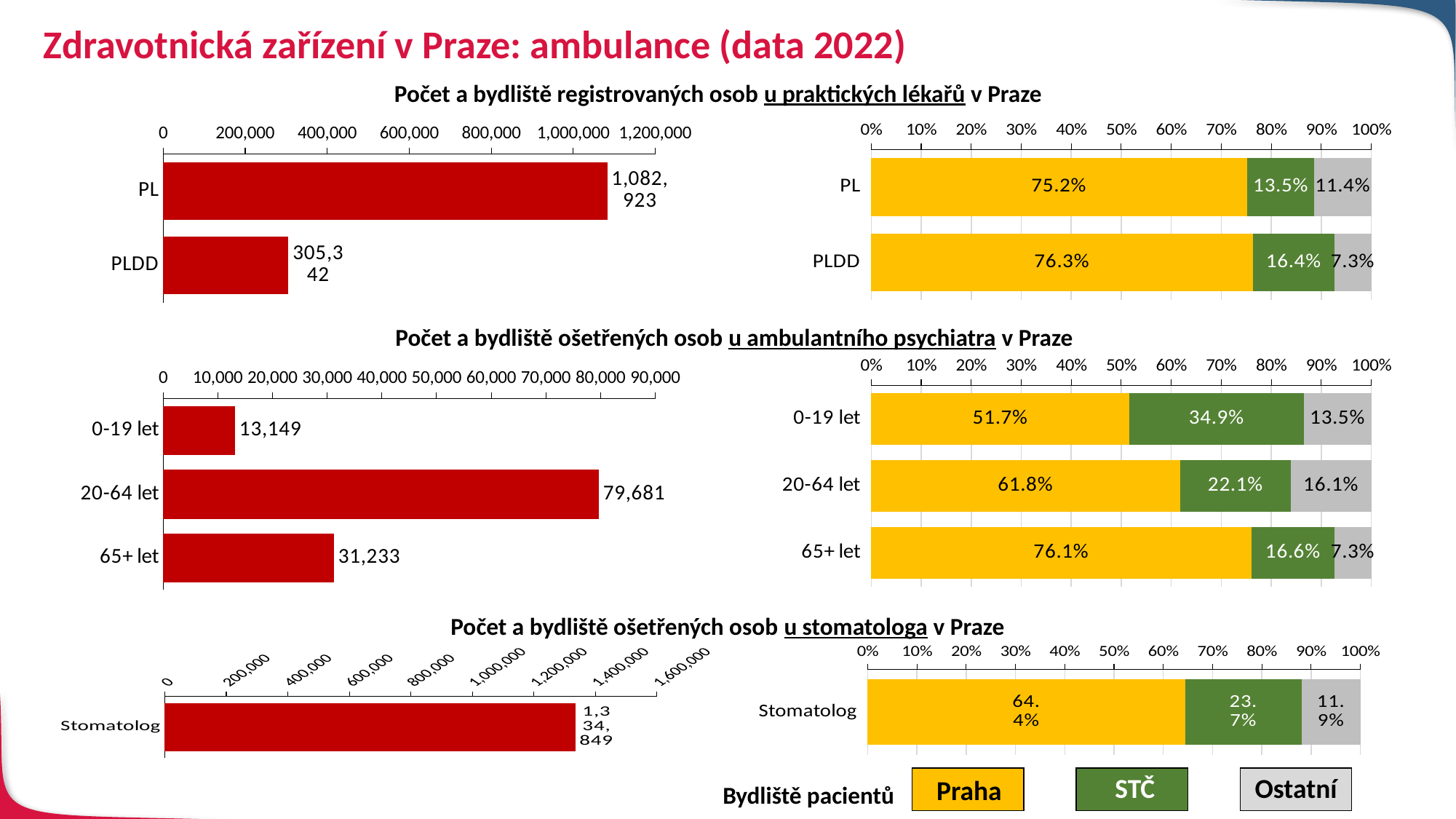
How many patient residence categories does the legend at the bottom of the slide list? 3 In the middle-right stacked bar chart (outpatient psychiatrist), which age group has the largest Praha share? 65+ let In the top-right stacked bar chart (general practitioners), what share of PLDD patients live in STČ? 16.4% In the top-left bar chart (registered persons at general practitioners), what is the value for PL? 1,082,923 In the middle-left bar chart (outpatient psychiatrist), what is the difference between the 20-64 let and 65+ let values? 48,448 In the top-right stacked bar chart (general practitioners), what share of PL patients live in Praha? 75.2% In the middle-left bar chart (outpatient psychiatrist), which age group has the lowest number of treated persons? 0-19 let In the top-left bar chart (registered persons at general practitioners), what is the value for PLDD? 305,342 In the bottom-left bar chart (stomatologist), what is the value for Stomatolog? 1,334,849 In the middle-left bar chart (outpatient psychiatrist), which age group has the highest number of treated persons? 20-64 let In the bottom-right stacked bar chart (stomatologist), what share of patients live in Ostatní (other) regions? 11.9% In the middle-right stacked bar chart (outpatient psychiatrist), what share of 0-19 let patients live in STČ? 34.9%